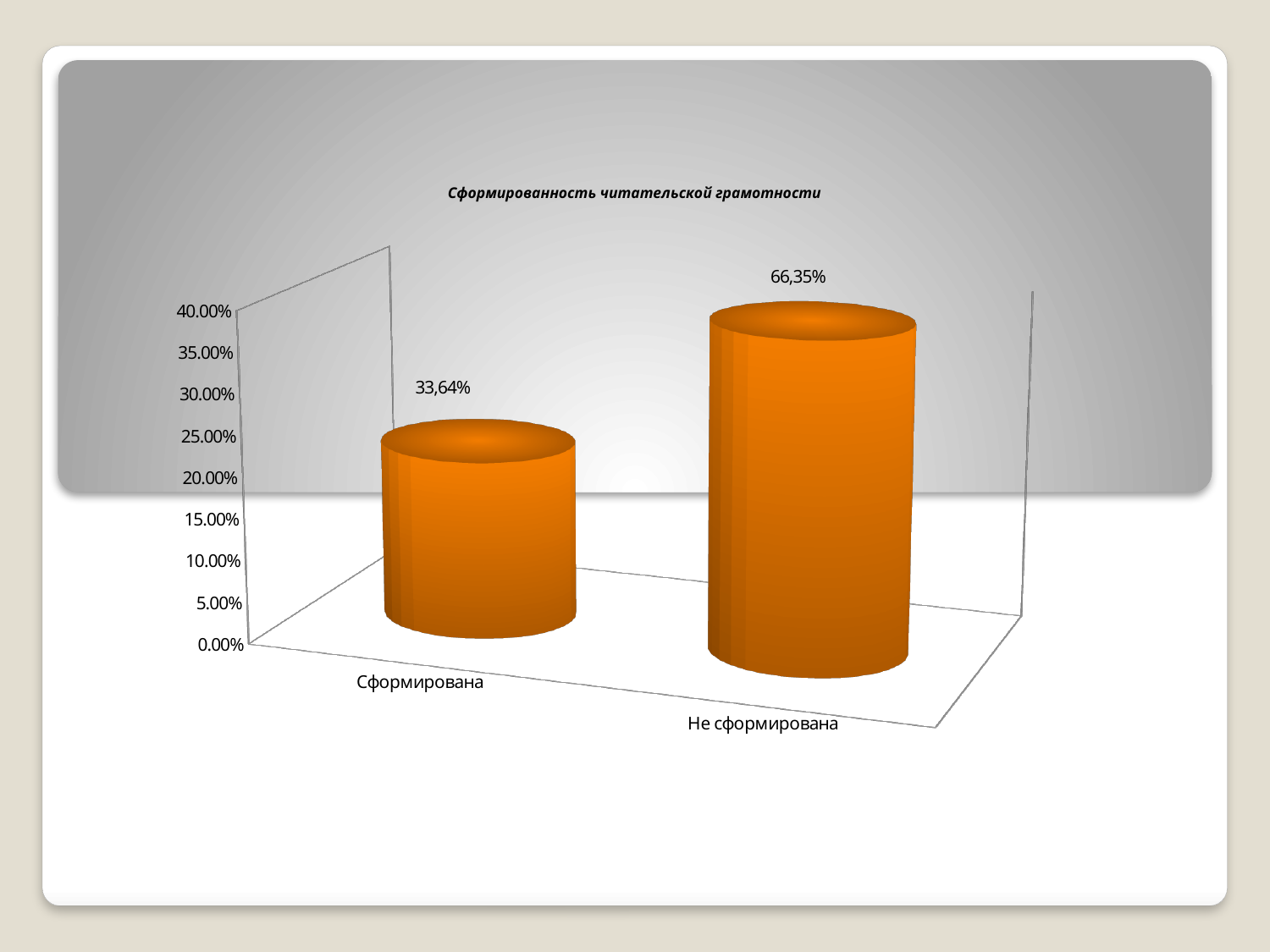
What is the value for Не сформирована? 66,35% What kind of chart is shown on the slide? Bar chart What colour are the bars on the chart? Orange What is the value for Сформирована? 33,64% Which category has the lowest value? Сформирована Which category has the highest value? Не сформирована What is the title of the chart? Сформированность читательской грамотности Which is larger: the value for Сформирована or the value for Не сформирована? Не сформирована How many categories are shown on the chart? 2 What is the highest tick value shown on the vertical axis? 40.00% What is the difference between the values for Не сформирована and Сформирована? 32,71%